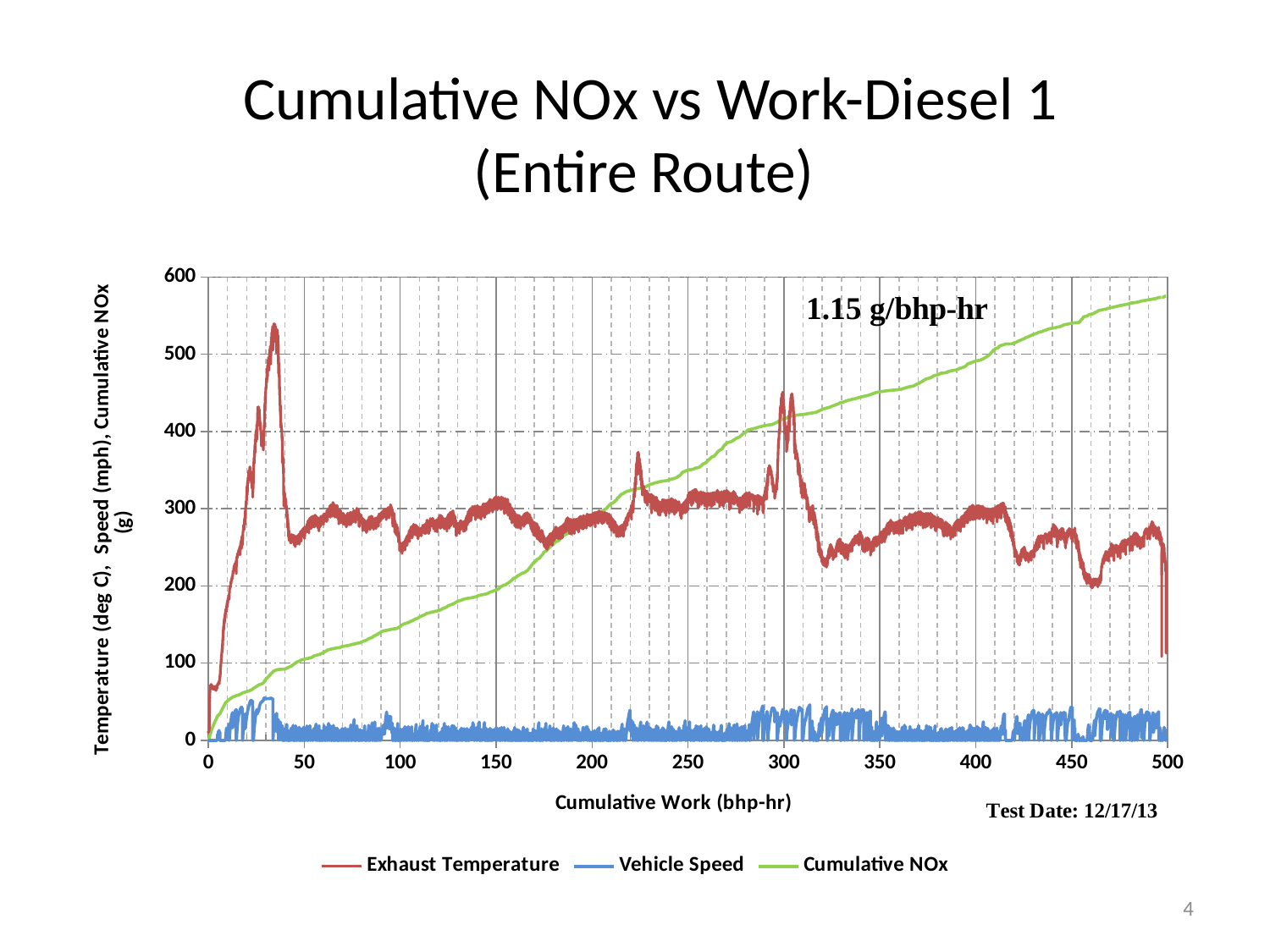
How many series does the legend list? 3 What colour is the Cumulative NOx line in the legend? Green At 400 bhp-hr of Cumulative Work, which is larger: Cumulative NOx or Exhaust Temperature? Cumulative NOx What NOx rate is printed as an annotation on the chart? 1.15 g/bhp-hr Which series has the lowest values across the whole route? Vehicle Speed Is the value of Cumulative NOx at 500 bhp-hr greater or less than 500? greater Is the highest value reached by the Exhaust Temperature series greater or less than 500? greater Is the value of Cumulative NOx at 100 bhp-hr greater or less than 200? less At 50 bhp-hr of Cumulative Work, which is larger: Exhaust Temperature or Cumulative NOx? Exhaust Temperature What kind of chart is shown on the slide? Line chart Does the Cumulative NOx series rise or fall as Cumulative Work increases from 0 to 500 bhp-hr? Rise